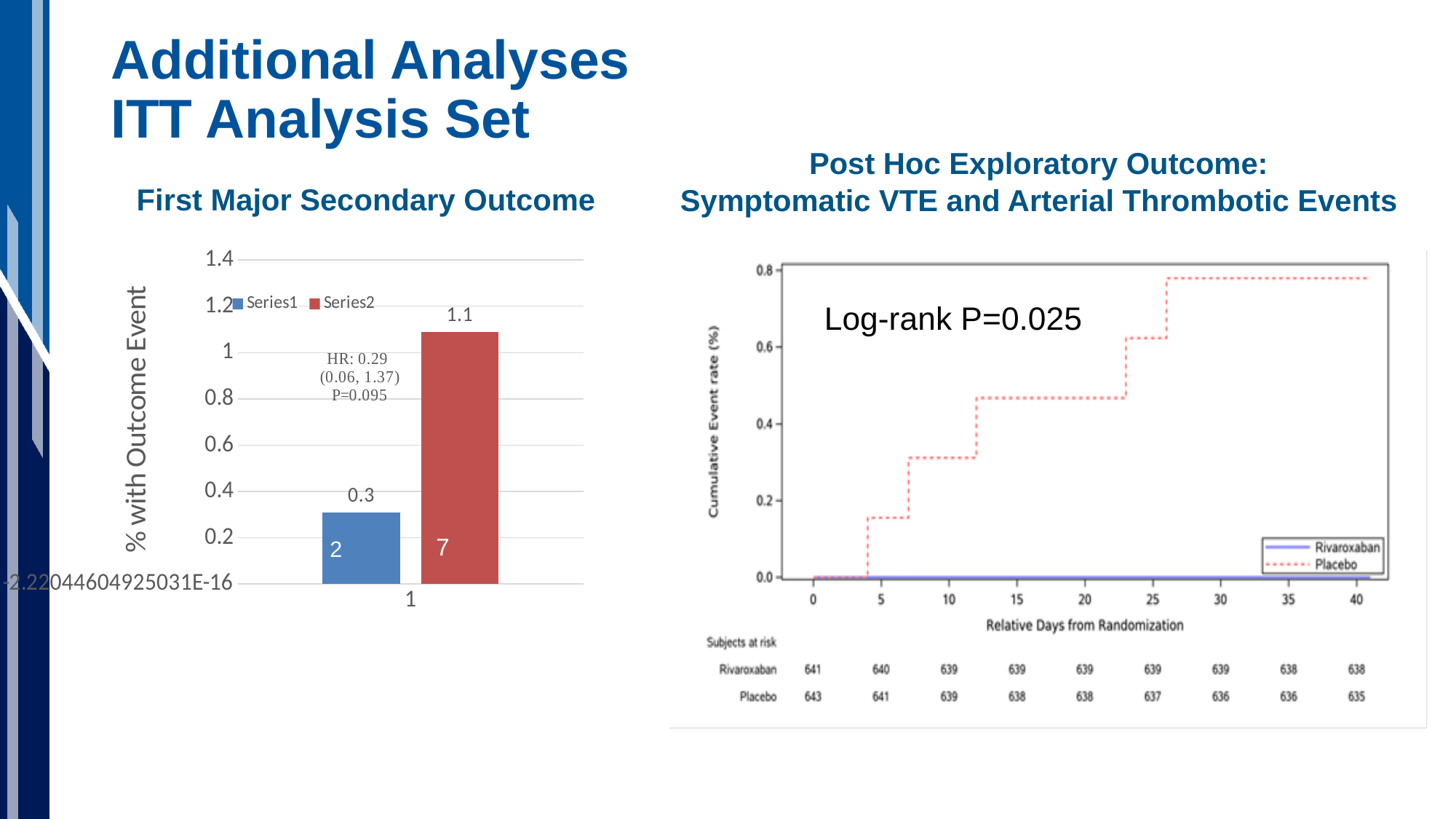
In the First Major Secondary Outcome chart, what is the y-axis title? % with Outcome Event What kind of chart is the First Major Secondary Outcome chart? Bar chart In the First Major Secondary Outcome chart, what is the difference between the Series2 and Series1 values? 0.8 In the Post Hoc Exploratory Outcome chart, does the Placebo cumulative event rate rise or fall as days from randomization increase? Rise In the Post Hoc Exploratory Outcome chart, how many groups does the legend list? 2 In the First Major Secondary Outcome chart, how many series does the legend list? 2 In the First Major Secondary Outcome chart, is the value for Series2 greater or less than 1? greater In the Post Hoc Exploratory Outcome chart, which group has the higher cumulative event rate at day 40? Placebo In the First Major Secondary Outcome chart, what is the value for Series2? 1.1 In the First Major Secondary Outcome chart, which series has the higher value? Series2 In the First Major Secondary Outcome chart, what number is printed inside the Series2 bar? 7 In the First Major Secondary Outcome chart, what is the value for Series1? 0.3